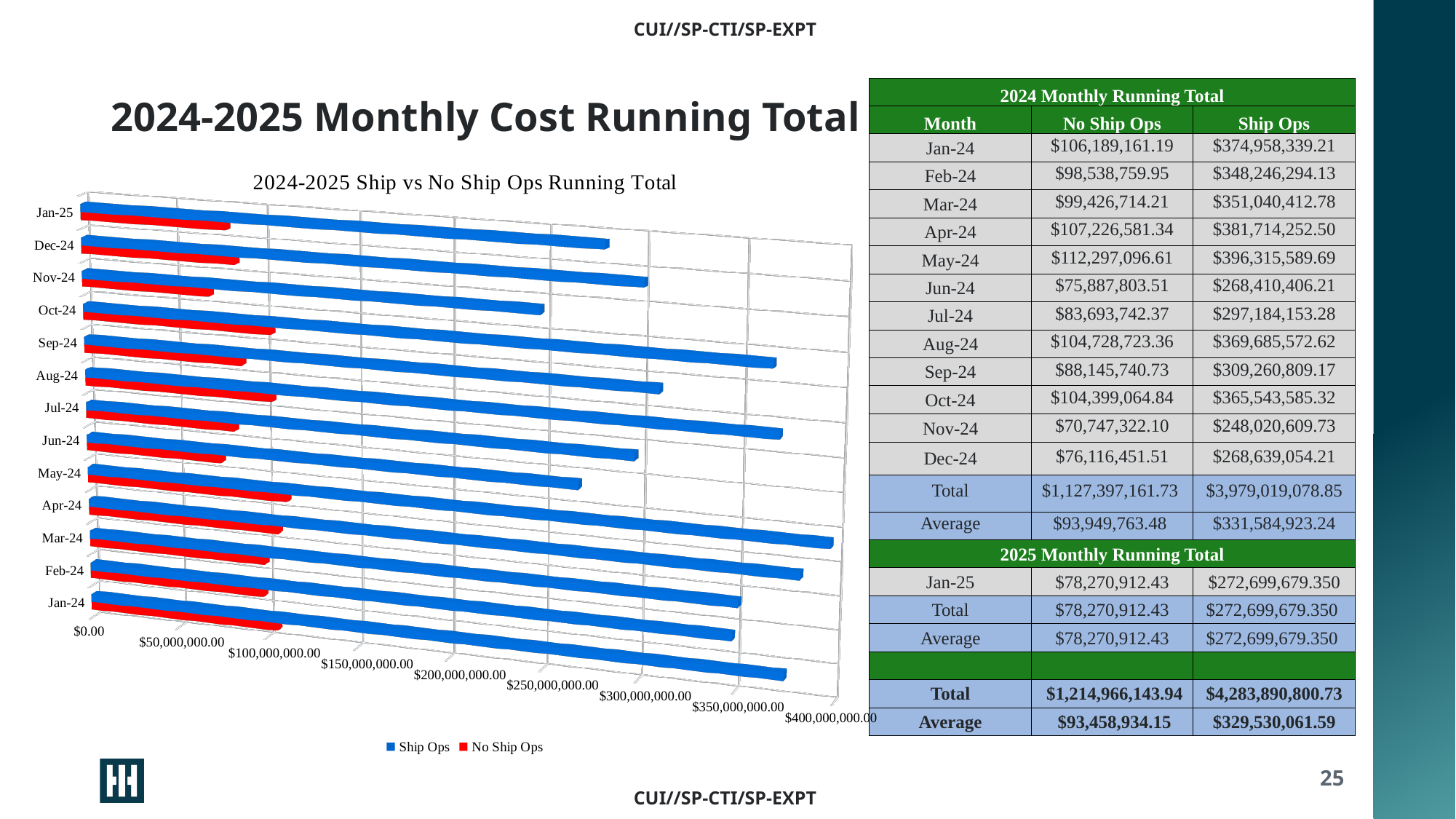
What is the difference between the Ship Ops and No Ship Ops values for Jan-24? $268,769,178.02 How many months are plotted on the chart's vertical axis? 13 Which month has the lowest No Ship Ops value? Nov-24 Which month has the highest Ship Ops value? May-24 Is the Ship Ops value for Nov-24 greater or less than $300,000,000.00? less What is the No Ship Ops value for Jun-24? $75,887,803.51 Which is larger, the Ship Ops value for Jan-24 or for Feb-24? Jan-24 What is the Ship Ops value for Jan-25? $272,699,679.350 Which colour represents the Ship Ops series in the chart? blue What kind of chart is shown on the slide? bar chart What is the chart's title? 2024-2025 Ship vs No Ship Ops Running Total How many series does the chart legend list? 2